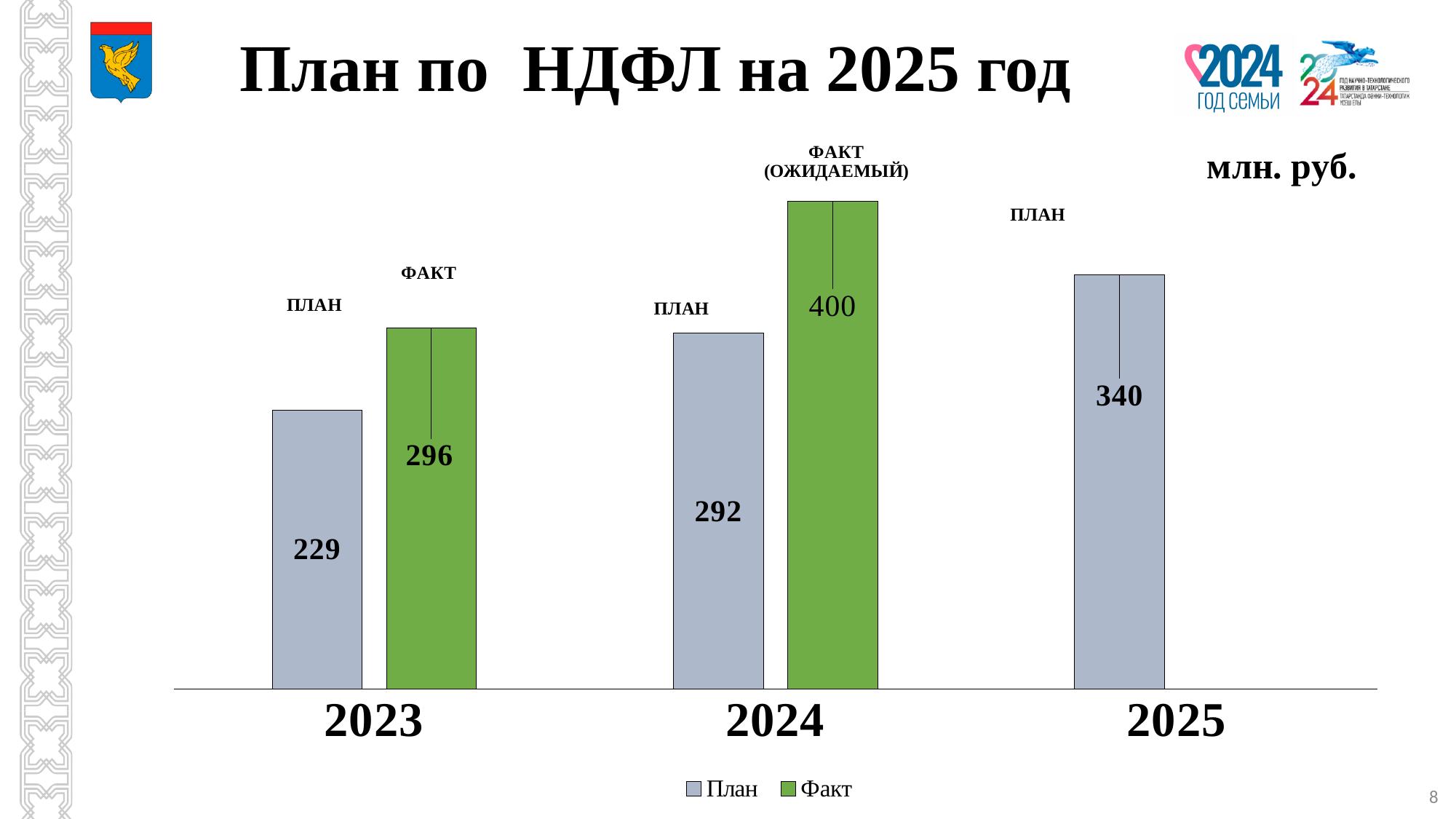
What is the Факт value for 2024? 400 What is the План value for 2025? 340 What is the Факт value for 2023? 296 Which year has the lowest План value? 2023 Which is larger in 2023, the План value or the Факт value? Факт What is the difference between the Факт and План values for 2024? 108 Do the План values rise or fall from 2023 to 2025? Rise What is the difference between the План values for 2025 and 2023? 111 How many series does the legend list? 2 What is the План value for 2023? 229 What kind of chart is shown on the slide? Bar chart Which year has the highest План value? 2025